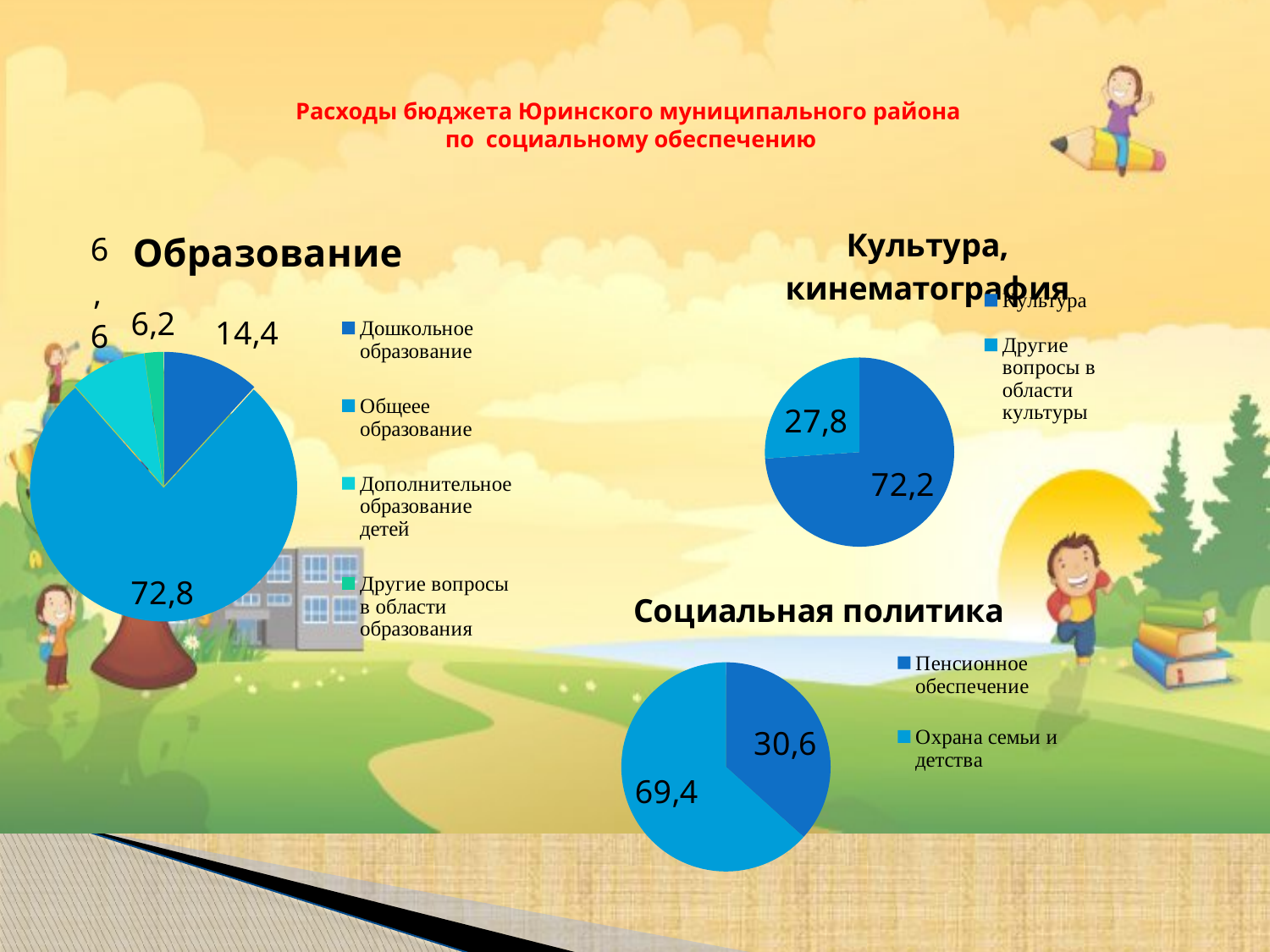
On the 'Культура, кинематография' chart, what value is shown for Культура? 72,2 On the 'Социальная политика' chart, what value is shown for Охрана семьи и детства? 69,4 On the 'Образование' chart, what value is shown for Дошкольное образование? 14,4 On the 'Культура, кинематография' chart, what value is shown for Другие вопросы в области культуры? 27,8 On the 'Образование' chart, what value is shown for Общеее образование? 72,8 What type of chart is the 'Социальная политика' chart? pie chart On the 'Образование' chart, what is the difference between Общеее образование and Дошкольное образование? 58,4 On the 'Образование' chart, what value is shown for Дополнительное образование детей? 6,6 On the 'Образование' chart, which category has the largest slice? Общеее образование On the 'Социальная политика' chart, what value is shown for Пенсионное обеспечение? 30,6 On the 'Культура, кинематография' chart, which is larger: Культура or Другие вопросы в области культуры? Культура On the 'Образование' chart, how many categories does the legend list? 4